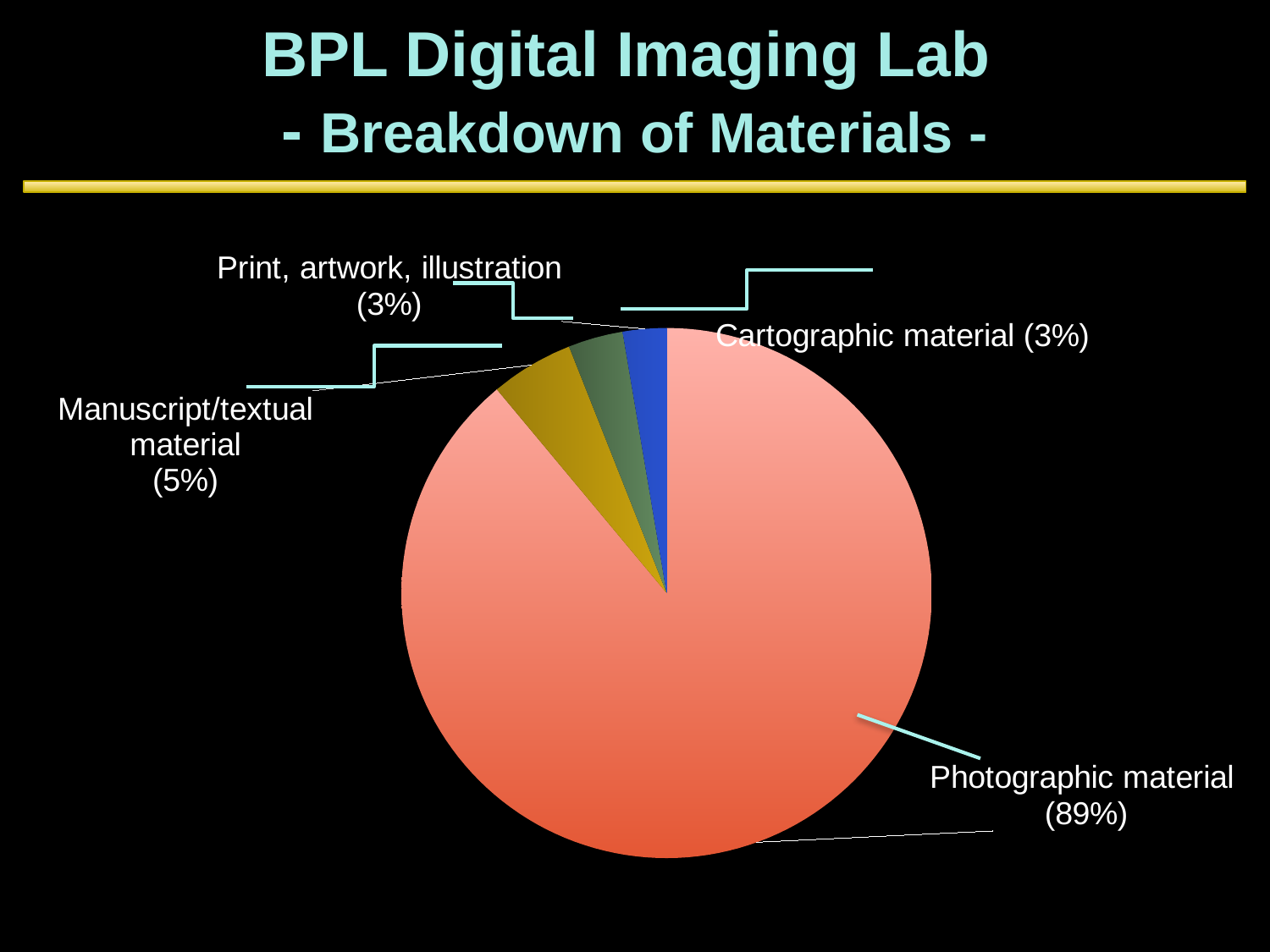
How many categories are shown in the pie chart? 4 What share of the pie does Photographic material represent? 89% What kind of chart is shown on the slide? Pie chart What is the title of the slide containing the chart? BPL Digital Imaging Lab - Breakdown of Materials - Which category has the largest slice of the pie? Photographic material Which is larger, the share for Manuscript/textual material or the share for Cartographic material? Manuscript/textual material What percentage is shown for Cartographic material? 3% What percentage is shown for Manuscript/textual material? 5% What is the difference in percentage points between Photographic material and Manuscript/textual material? 84 What percentage is shown for Print, artwork, illustration? 3% What is the combined percentage of Print, artwork, illustration and Cartographic material? 6%